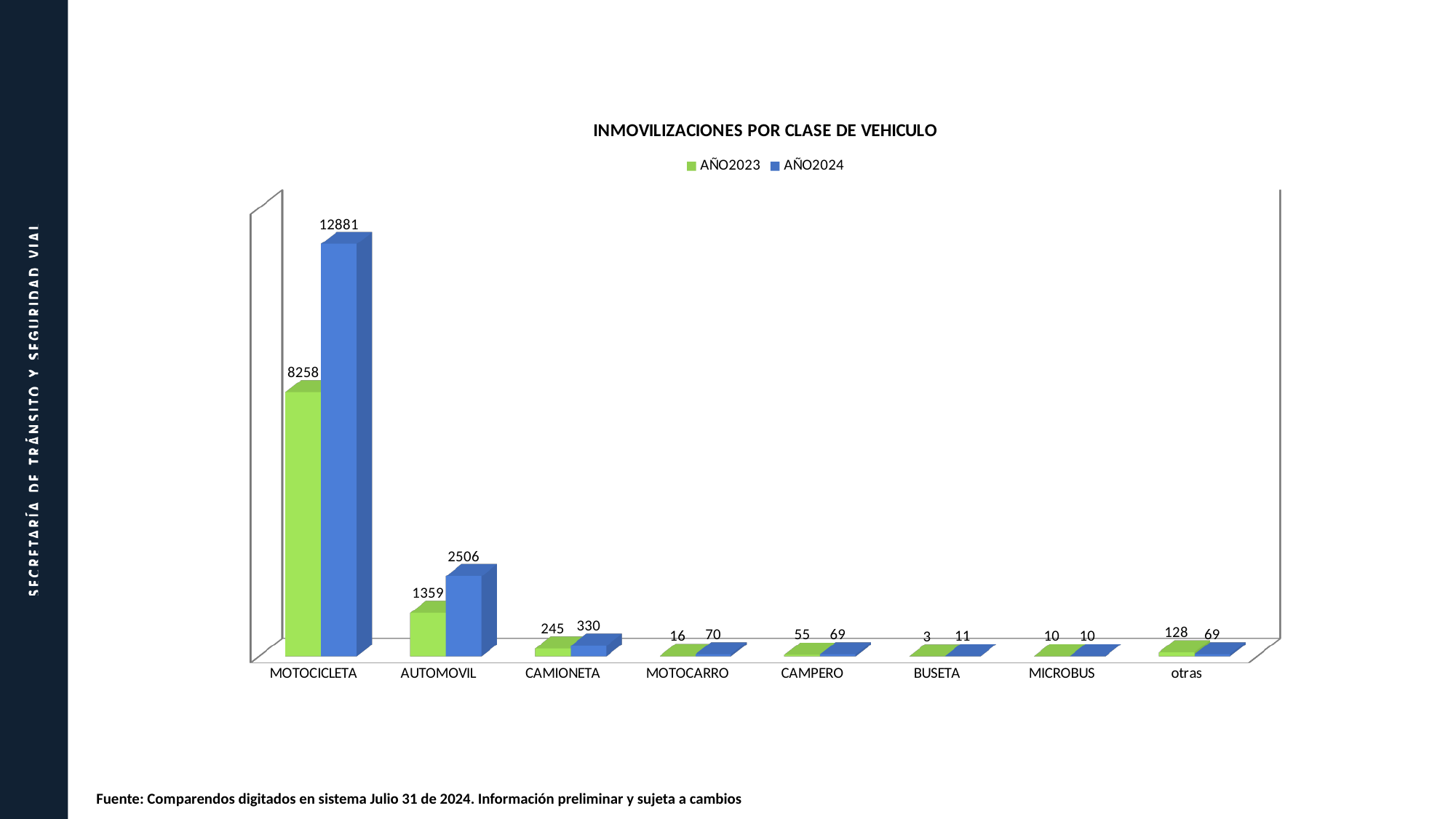
How many vehicle categories are shown on the x axis? 8 What is the value for MOTOCICLETA in the AÑO2024 series? 12881 What is the value for BUSETA in the AÑO2024 series? 11 Which category has the highest value in the AÑO2023 series? MOTOCICLETA What kind of chart is shown on the slide? Bar chart How many series does the legend list? 2 What is the difference between the AÑO2024 and AÑO2023 values for MOTOCICLETA? 4623 Which category has the lowest value in the AÑO2023 series? BUSETA Which is larger for otras: the AÑO2023 value or the AÑO2024 value? AÑO2023 What is the value for AUTOMOVIL in the AÑO2023 series? 1359 What is the title of the chart? INMOVILIZACIONES POR CLASE DE VEHICULO What is the difference between the AÑO2024 and AÑO2023 values for AUTOMOVIL? 1147